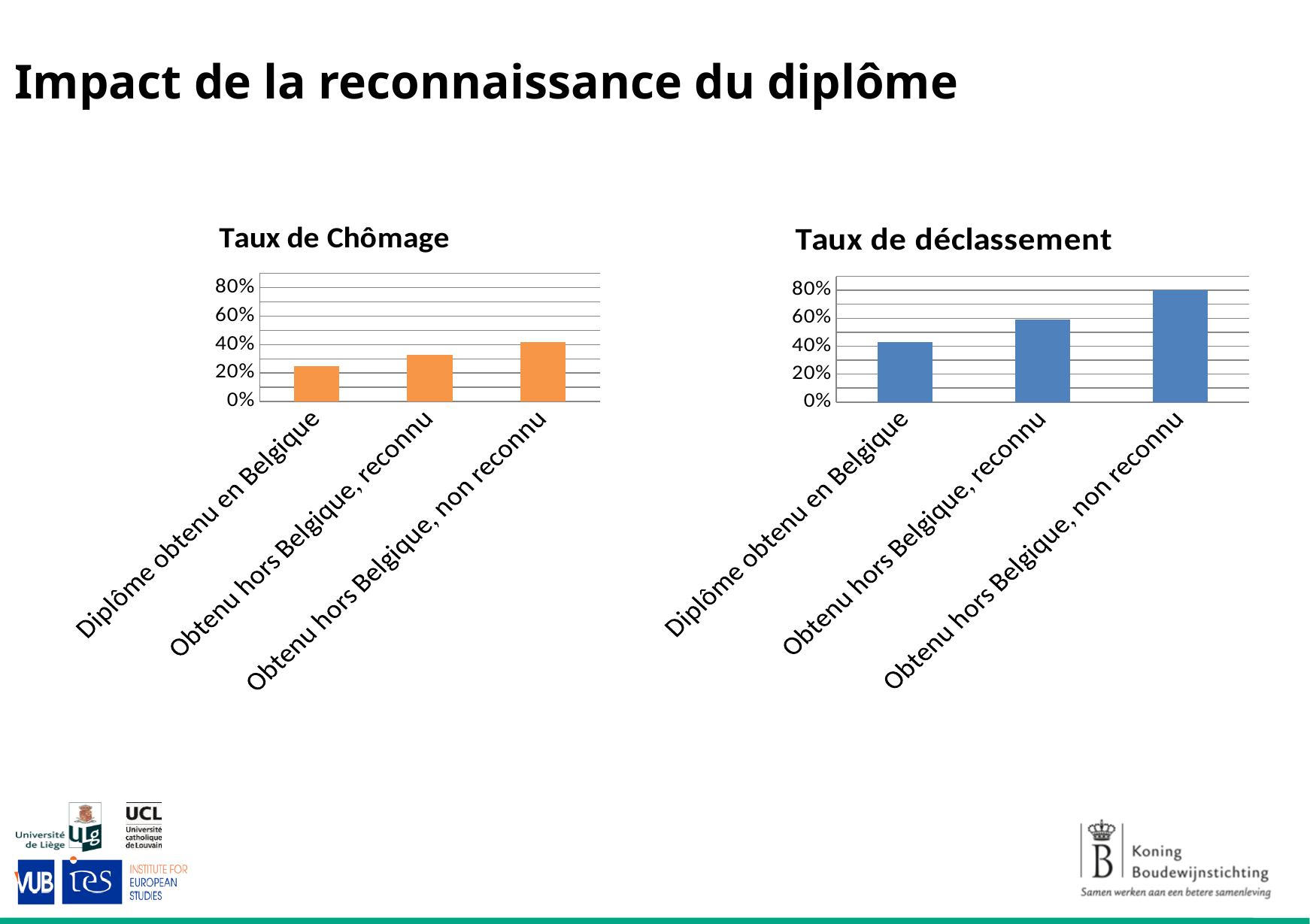
How many categories are shown in the 'Taux de déclassement' chart? 3 In the 'Taux de Chômage' chart, is the value for 'Obtenu hors Belgique, non reconnu' greater or less than 60%? less In the 'Taux de déclassement' chart, which is larger: the value for 'Obtenu hors Belgique, reconnu' or for 'Diplôme obtenu en Belgique'? Obtenu hors Belgique, reconnu In the 'Taux de Chômage' chart, which category has the lowest value? Diplôme obtenu en Belgique In the 'Taux de déclassement' chart, is the value for 'Obtenu hors Belgique, non reconnu' greater or less than 60%? greater What kind of chart is the 'Taux de Chômage' chart? bar chart In the 'Taux de Chômage' chart, is the value for 'Obtenu hors Belgique, reconnu' greater or less than 20%? greater In the 'Taux de Chômage' chart, which category has the highest value? Obtenu hors Belgique, non reconnu In the 'Taux de déclassement' chart, which category has the lowest value? Diplôme obtenu en Belgique In the 'Taux de déclassement' chart, which category has the highest value? Obtenu hors Belgique, non reconnu